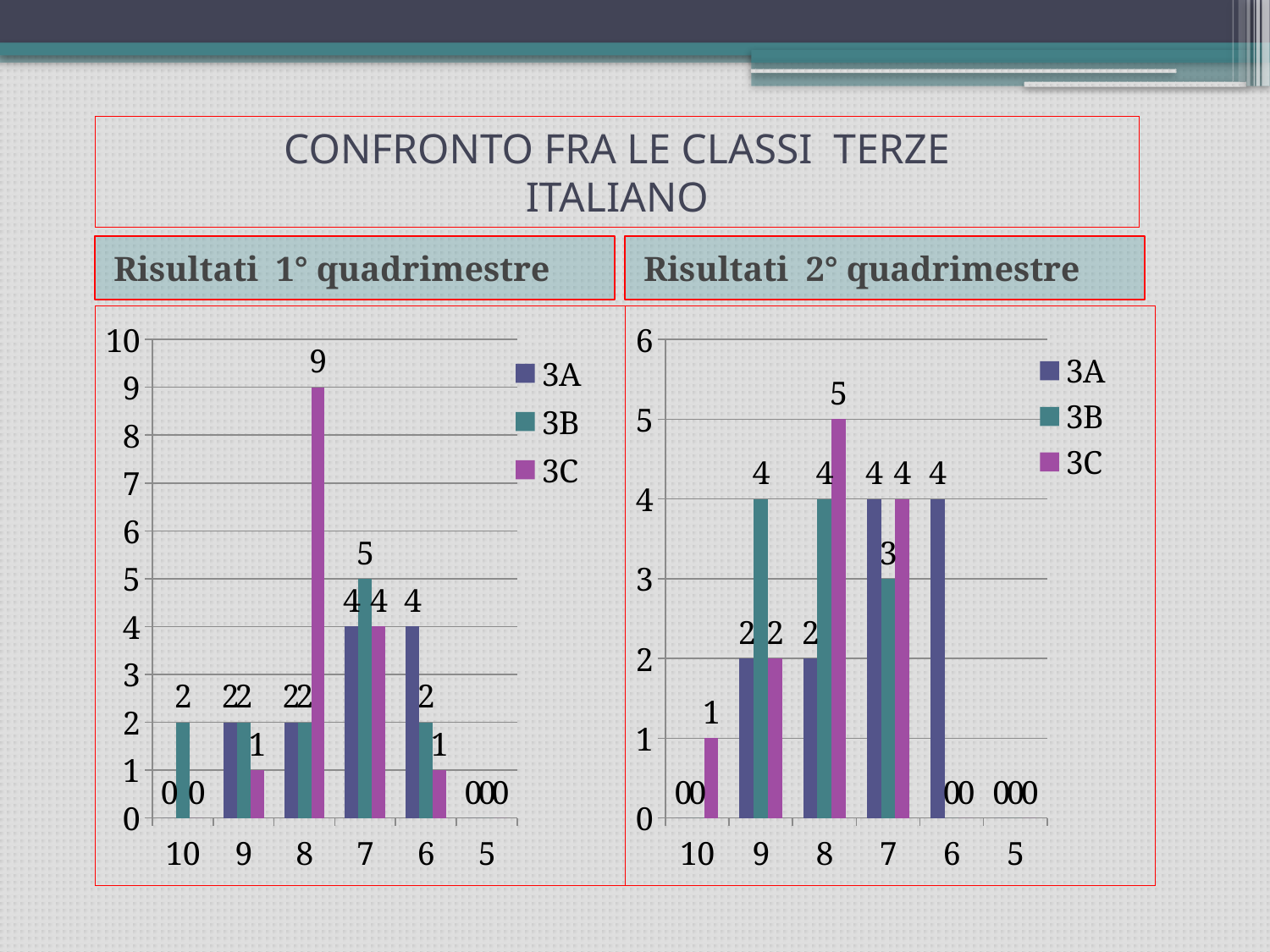
In the 'Risultati 1° quadrimestre' chart, which grade has the highest value for 3C? 8 In the 'Risultati 1° quadrimestre' chart, what is the difference between the 3C value at grade 8 and the 3A value at grade 8? 7 In the 'Risultati 2° quadrimestre' chart, which series has the highest value at grade 8? 3C In the 'Risultati 1° quadrimestre' chart, what is the value for 3B at grade 7? 5 In the 'Risultati 2° quadrimestre' chart, what is the total of the three series at grade 7? 11 In the 'Risultati 2° quadrimestre' chart, which is larger at grade 9: the value for 3B or the value for 3A? 3B In the 'Risultati 1° quadrimestre' chart, what is the value for 3C at grade 8? 9 In the 'Risultati 2° quadrimestre' chart, what is the value for 3B at grade 7? 3 How many grade categories are shown on the x axis of the 'Risultati 1° quadrimestre' chart? 6 How many series does the legend of the 'Risultati 2° quadrimestre' chart list? 3 What kind of chart is the 'Risultati 1° quadrimestre' chart? Bar chart In the 'Risultati 2° quadrimestre' chart, what is the value for 3C at grade 8? 5